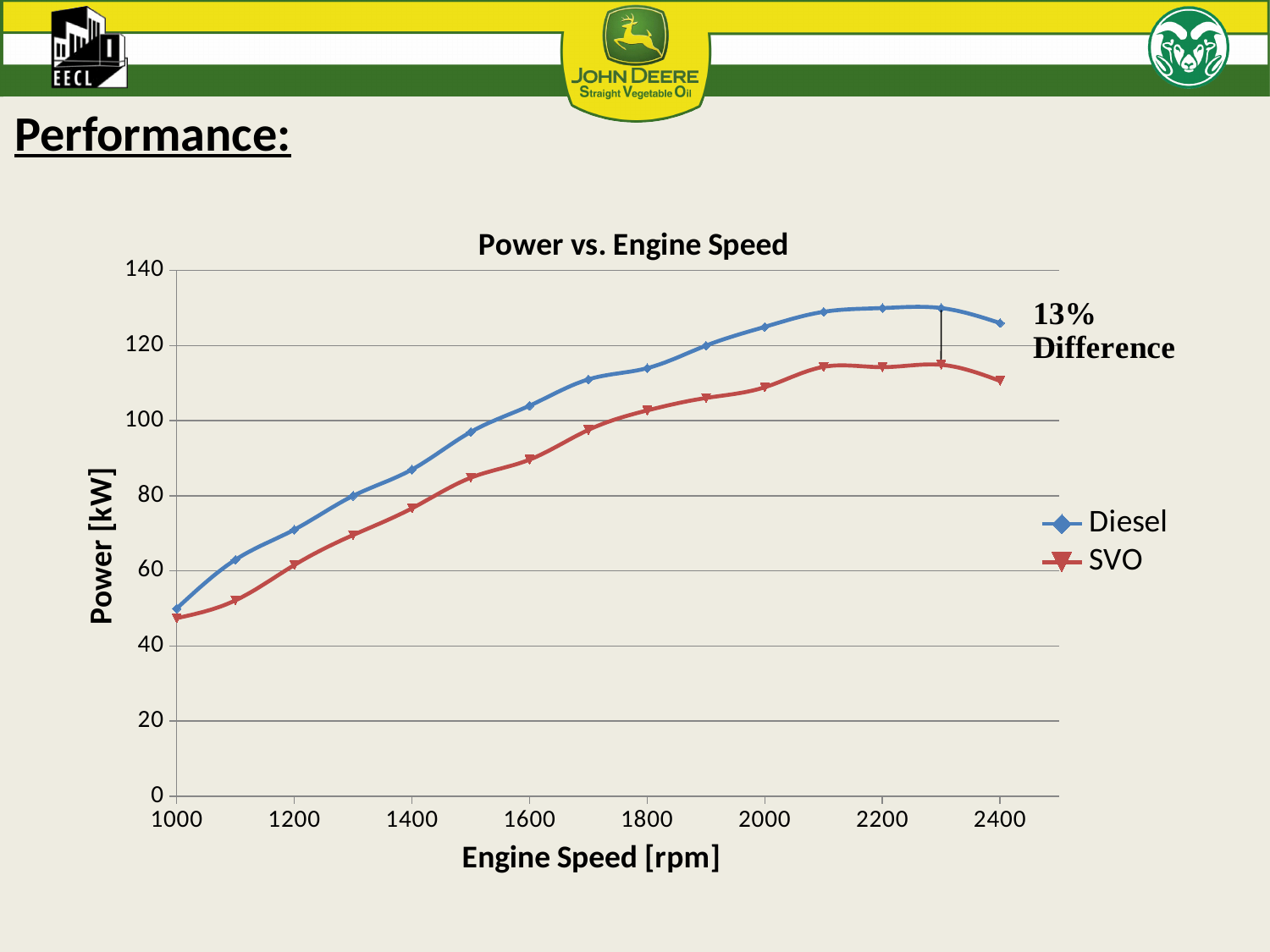
Is the Diesel value at 2200 rpm greater or less than 120? greater Is the SVO value at 2400 rpm greater or less than 100? greater What is the title of the chart? Power vs. Engine Speed Which series has the higher power at 1600 rpm, Diesel or SVO? Diesel How many data points are plotted for the Diesel series? 15 What percentage difference is annotated on the chart? 13% Is the SVO value at 1000 rpm greater or less than 60? less Does the Diesel power generally rise or fall as engine speed increases from 1000 to 2200 rpm? rise How many series does the legend list? 2 At which engine speed is the SVO power lowest? 1000 What kind of chart is shown on the slide? line chart